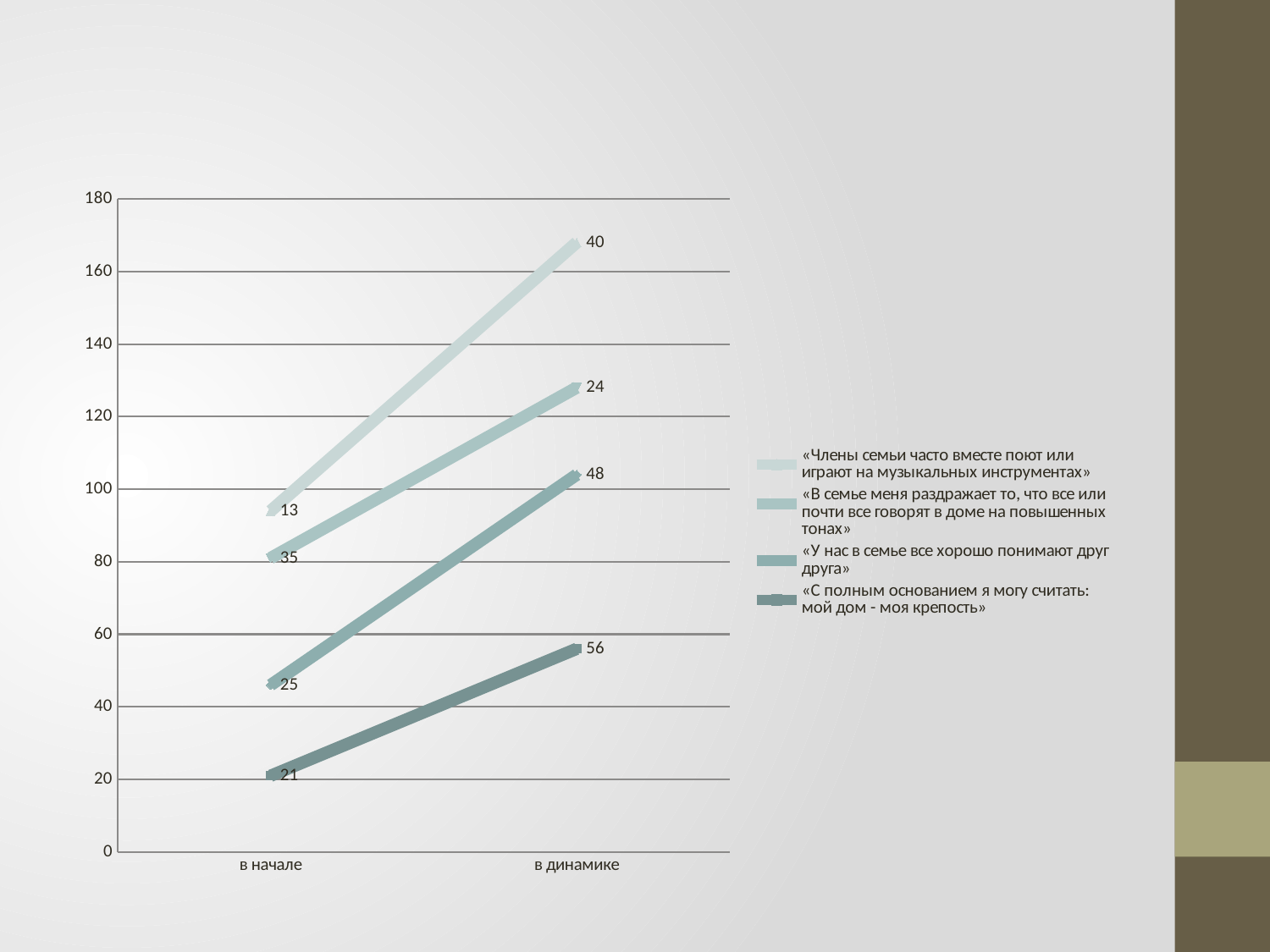
How many categories are on the x axis? 2 Which series has the lowest data label at «в начале»? «Члены семьи часто вместе поют или играют на музыкальных инструментах» What is the value for «Члены семьи часто вместе поют или играют на музыкальных инструментах» at «в динамике»? 40 What is the value for «Члены семьи часто вместе поют или играют на музыкальных инструментах» at «в начале»? 13 What is the value for «С полным основанием я могу считать: мой дом - моя крепость» at «в динамике»? 56 What kind of chart is shown on the slide? line chart Which series has the highest data label at «в динамике»? «С полным основанием я могу считать: мой дом - моя крепость» What is the value for «У нас в семье все хорошо понимают друг друга» at «в начале»? 25 How many series does the legend list? 4 By how much does the value for «С полным основанием я могу считать: мой дом - моя крепость» change from «в начале» to «в динамике»? 35 Does the value for «В семье меня раздражает то, что все или почти все говорят в доме на повышенных тонах» rise or fall from «в начале» to «в динамике»? fall Which is larger: the value for «В семье меня раздражает то, что все или почти все говорят в доме на повышенных тонах» at «в начале» or at «в динамике»? в начале